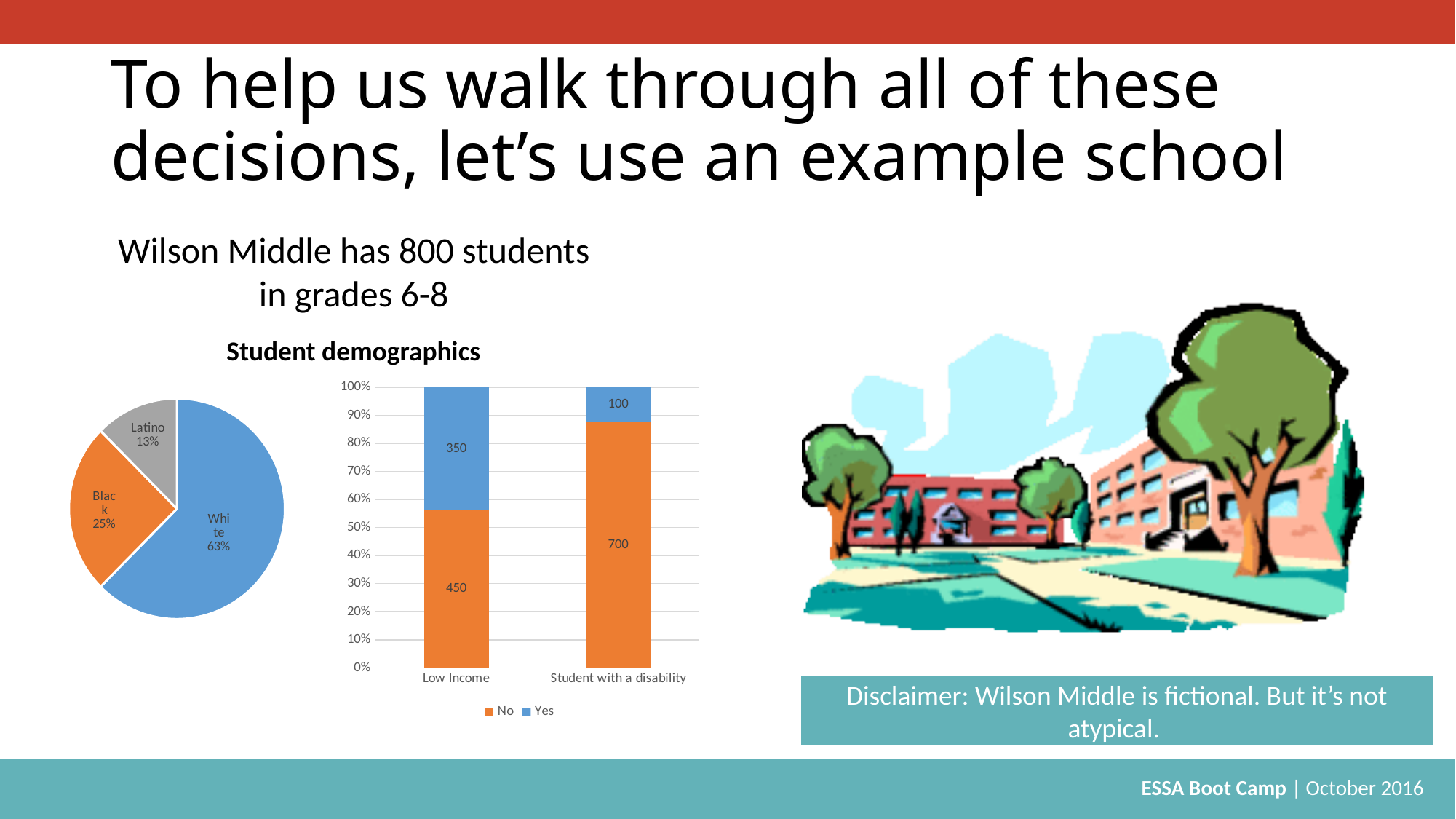
In the pie chart on the left, what share of students is Latino? 13% In the pie chart on the left, which group has the largest share? White What type of chart is the chart on the right of the 'Student demographics' section? Stacked bar chart In the stacked bar chart, which category has the larger 'No' value, Low Income or Student with a disability? Student with a disability In the stacked bar chart, what is the difference between the 'Yes' values for Low Income and Student with a disability? 250 In the stacked bar chart, what is the 'No' value for Low Income? 450 How many series does the legend of the stacked bar chart list? 2 In the pie chart on the left, how many slices are there? 3 In the stacked bar chart, what is the total of the Low Income bar? 800 In the pie chart on the left, which group has the smallest share? Latino In the pie chart on the left, what share of students is White? 63% In the stacked bar chart, what is the 'Yes' value for Student with a disability? 100